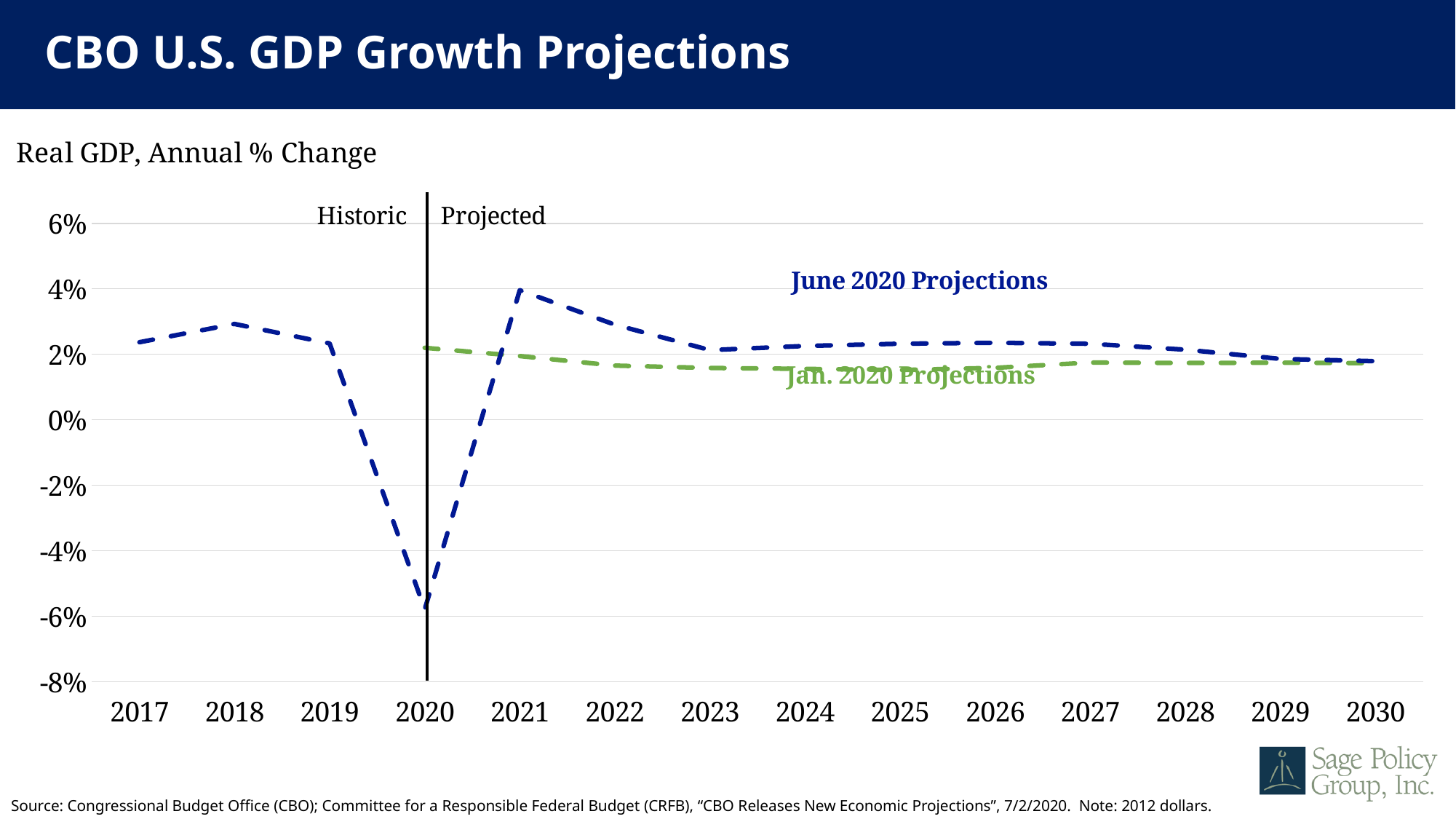
For 2021, which series shows the larger value: June 2020 Projections or Jan. 2020 Projections? June 2020 Projections Is the June 2020 Projections value for 2020 greater or less than -4%? less In which year does the June 2020 Projections line reach its highest value? 2021 What kind of chart is shown on the slide? line chart Which series is drawn in green? Jan. 2020 Projections Is the Jan. 2020 Projections value for 2020 greater or less than 0%? greater Is the June 2020 Projections value for 2021 greater or less than 2%? greater How many years are shown along the x axis? 14 Does the June 2020 Projections line rise or fall from 2021 to 2023? fall How many series are plotted on the chart? 2 In which year does the June 2020 Projections line reach its lowest value? 2020 What is the y-axis label shown above the chart? Real GDP, Annual % Change